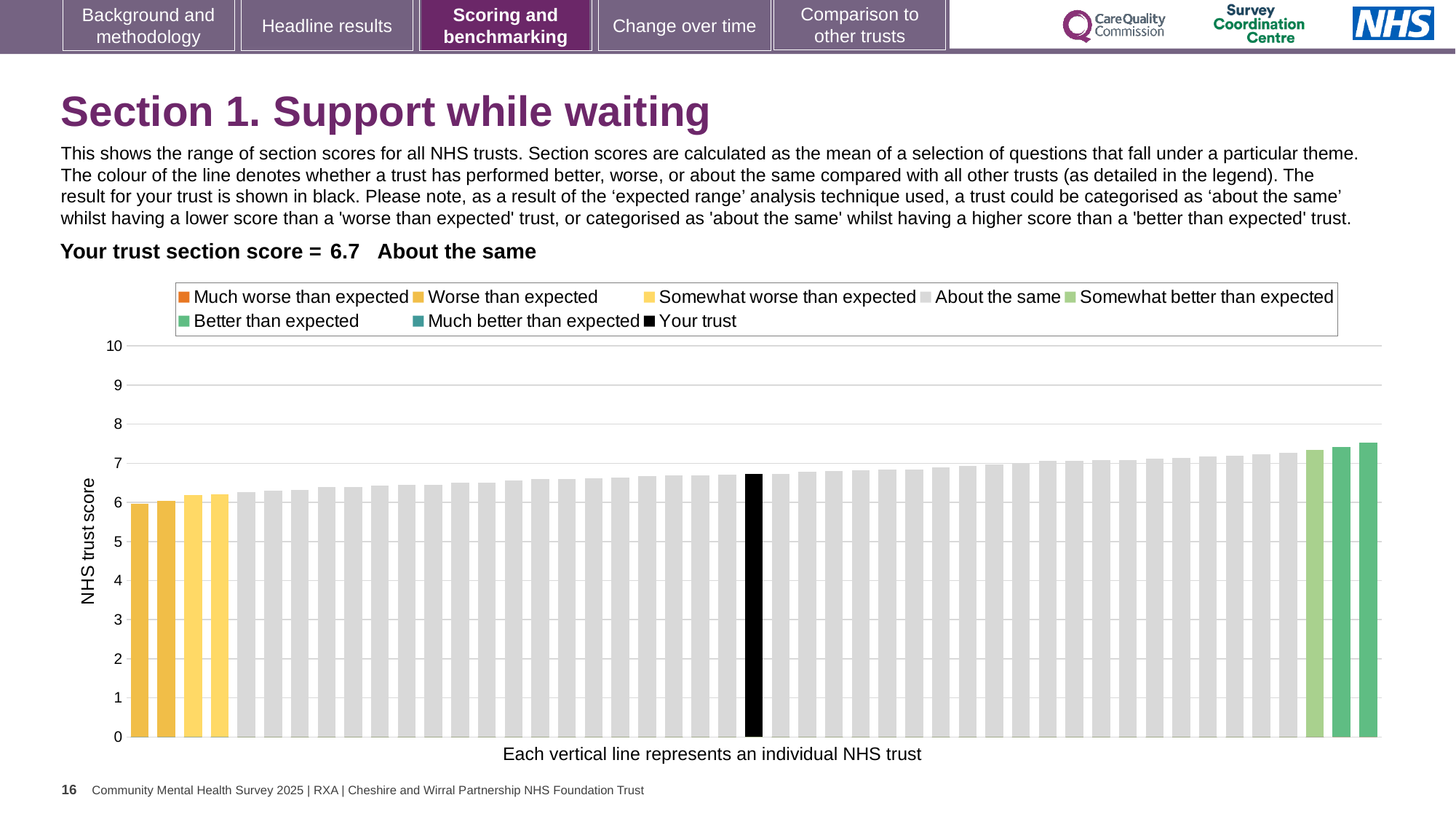
How many bars are coloured as 'Better than expected' (green) in the chart? 2 Which performance category is your trust placed in for this section? About the same Is the value of the shortest bar in the chart greater or less than 5? greater How many bars are coloured as 'Worse than expected' (dark yellow) in the chart? 2 Is the value of the black bar (your trust) greater or less than 5? greater What kind of chart is shown on the slide? bar chart What colour is the bar representing your trust in the chart? black What is the title of the y axis of the chart? NHS trust score Do the bar values rise or fall moving from left to right along the x axis? rise How many entries does the chart legend list? 8 Is the value of the tallest bar in the chart greater or less than 8? less What is the section score for your trust shown on the slide? 6.7